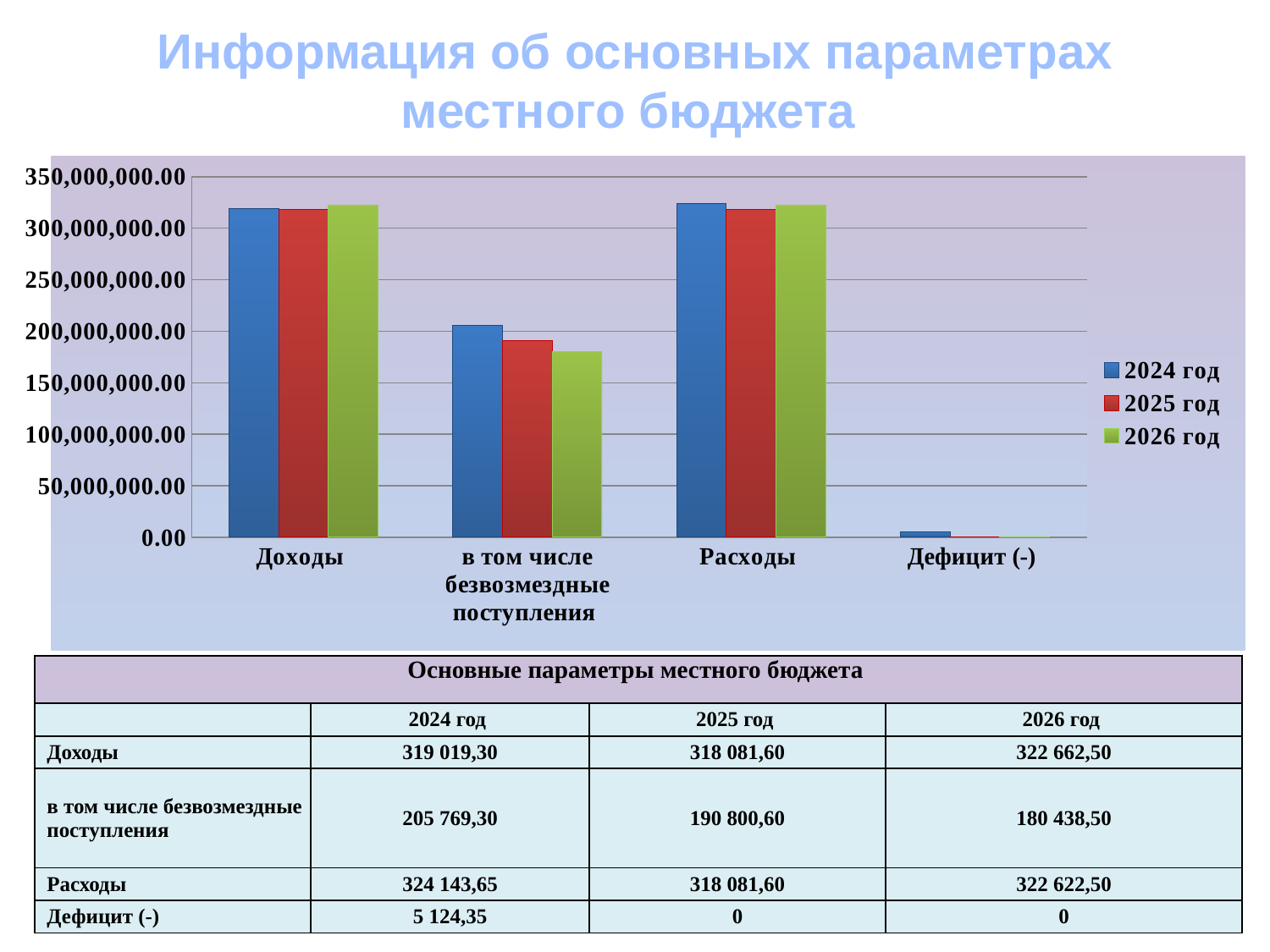
For в том числе безвозмездные поступления, which year has the lowest bar? 2026 год How many series does the chart legend list? 3 Is the value for Расходы in 2026 год greater or less than 300,000,000.00? greater Which series is shown in green in the chart? 2026 год How many categories are shown on the x axis of the chart? 4 Do the values for в том числе безвозмездные поступления rise or fall from 2024 год to 2026 год? fall Is the value for Дефицит (-) in 2024 год greater or less than 50,000,000.00? less Which category has the lowest values across all three years? Дефицит (-) Is the value for в том числе безвозмездные поступления in 2025 год greater or less than 200,000,000.00? less What kind of chart is shown on the slide? bar chart For в том числе безвозмездные поступления, which year has the highest bar? 2024 год